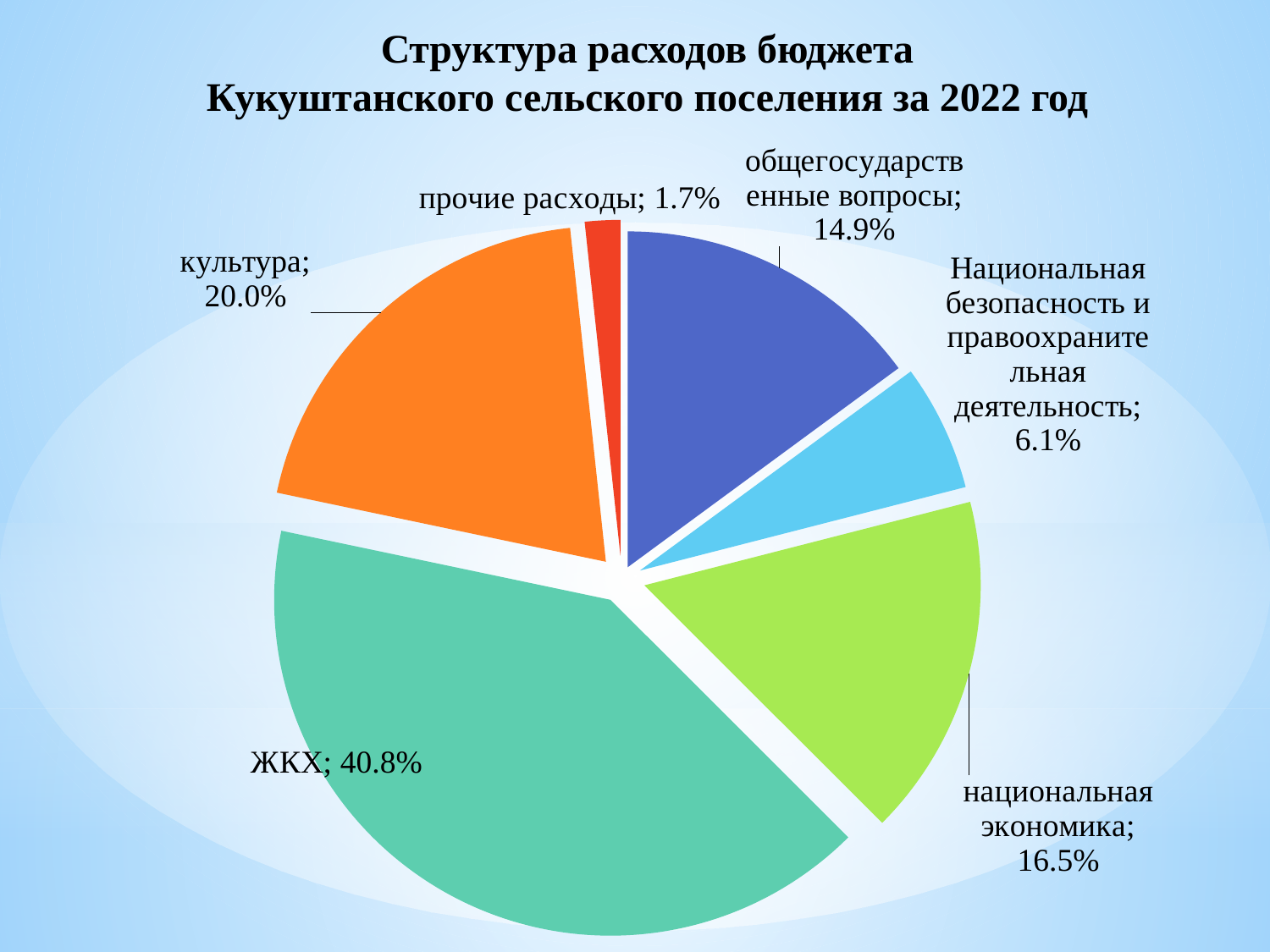
What is the share for общегосударственные вопросы? 14.9% What percentage is shown for культура? 20.0% What share of the budget expenditure goes to ЖКХ? 40.8% What is the title of the chart? Структура расходов бюджета Кукуштанского сельского поселения за 2022 год Which is larger, the share for национальная экономика or for общегосударственные вопросы? национальная экономика What is the difference in percentage points between ЖКХ and культура? 20.8 Which category has the smallest share of expenditure? прочие расходы Which category has the largest share of expenditure? ЖКХ How many categories are shown in the pie chart? 6 What percentage is shown for национальная экономика? 16.5% What type of chart is shown on the slide? pie chart What share is shown for Национальная безопасность и правоохранительная деятельность? 6.1%